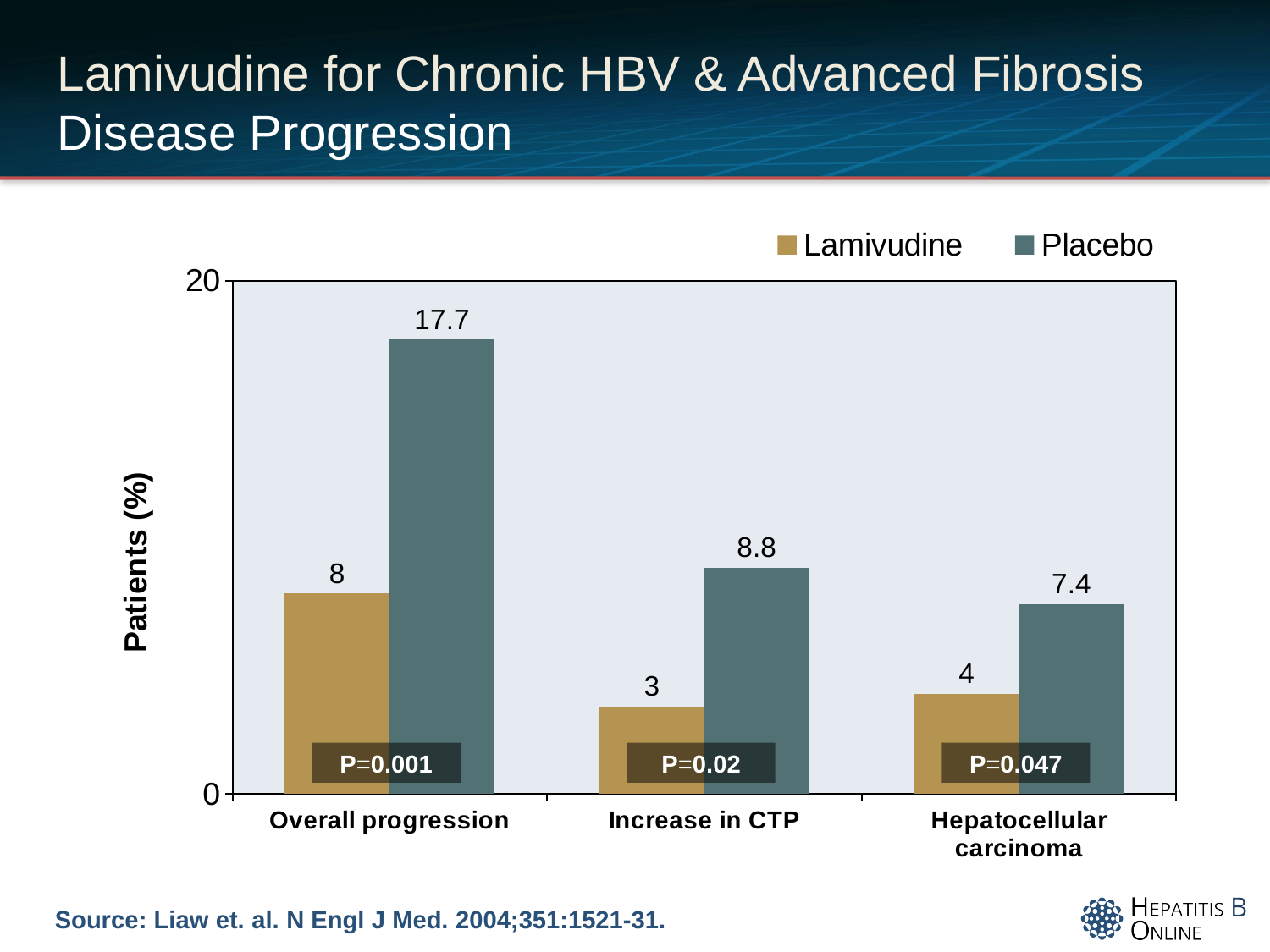
How many categories are shown on the x axis? 3 Which category has the highest Placebo value? Overall progression What kind of chart is shown on the slide? Bar chart What is the Lamivudine value for Hepatocellular carcinoma? 4 What percentage of patients in the Lamivudine group had overall progression? 8 How many series does the legend list? 2 What is the difference between the Placebo and Lamivudine values for Overall progression? 9.7 What percentage of patients in the Placebo group had overall progression? 17.7 Which category has the lowest Lamivudine value? Increase in CTP Which is larger for Increase in CTP: the Lamivudine value or the Placebo value? Placebo What is the difference between the Placebo and Lamivudine values for Hepatocellular carcinoma? 3.4 What is the Placebo value for Increase in CTP? 8.8